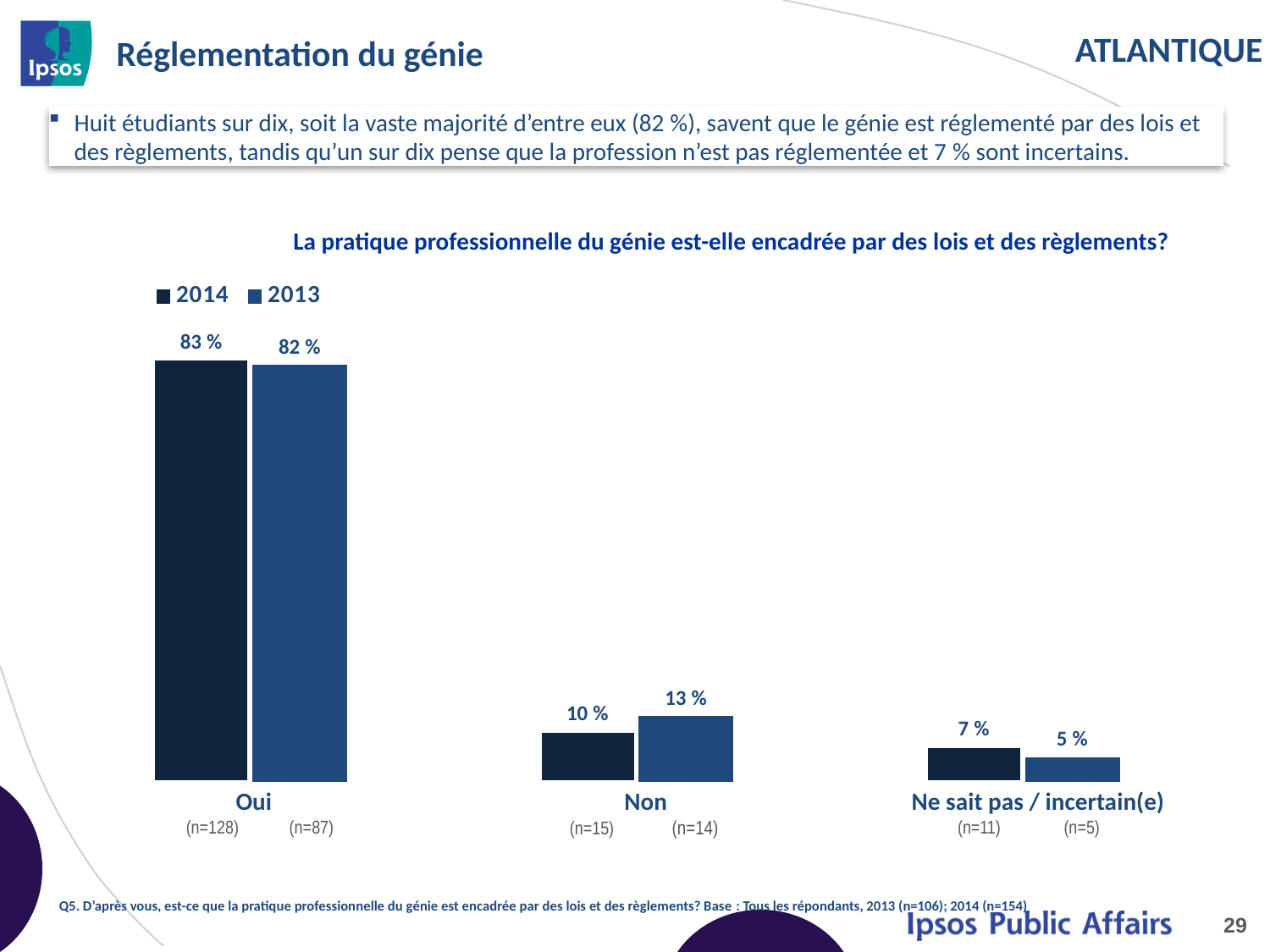
What is the 2013 value for "Ne sait pas / incertain(e)"? 5 % Which category has the lowest 2013 value? Ne sait pas / incertain(e) How many series does the legend list? 2 For "Ne sait pas / incertain(e)", which year has the larger value, 2014 or 2013? 2014 What are the series names listed in the legend? 2014 and 2013 What is the 2013 value for "Non"? 13 % What kind of chart is shown on the slide? Bar chart What is the 2014 value for "Oui"? 83 % What is the difference between the 2013 and 2014 values for "Non"? 3 % How many categories are shown on the x axis? 3 Which category has the highest 2014 value? Oui What is the title of the chart? La pratique professionnelle du génie est-elle encadrée par des lois et des règlements?